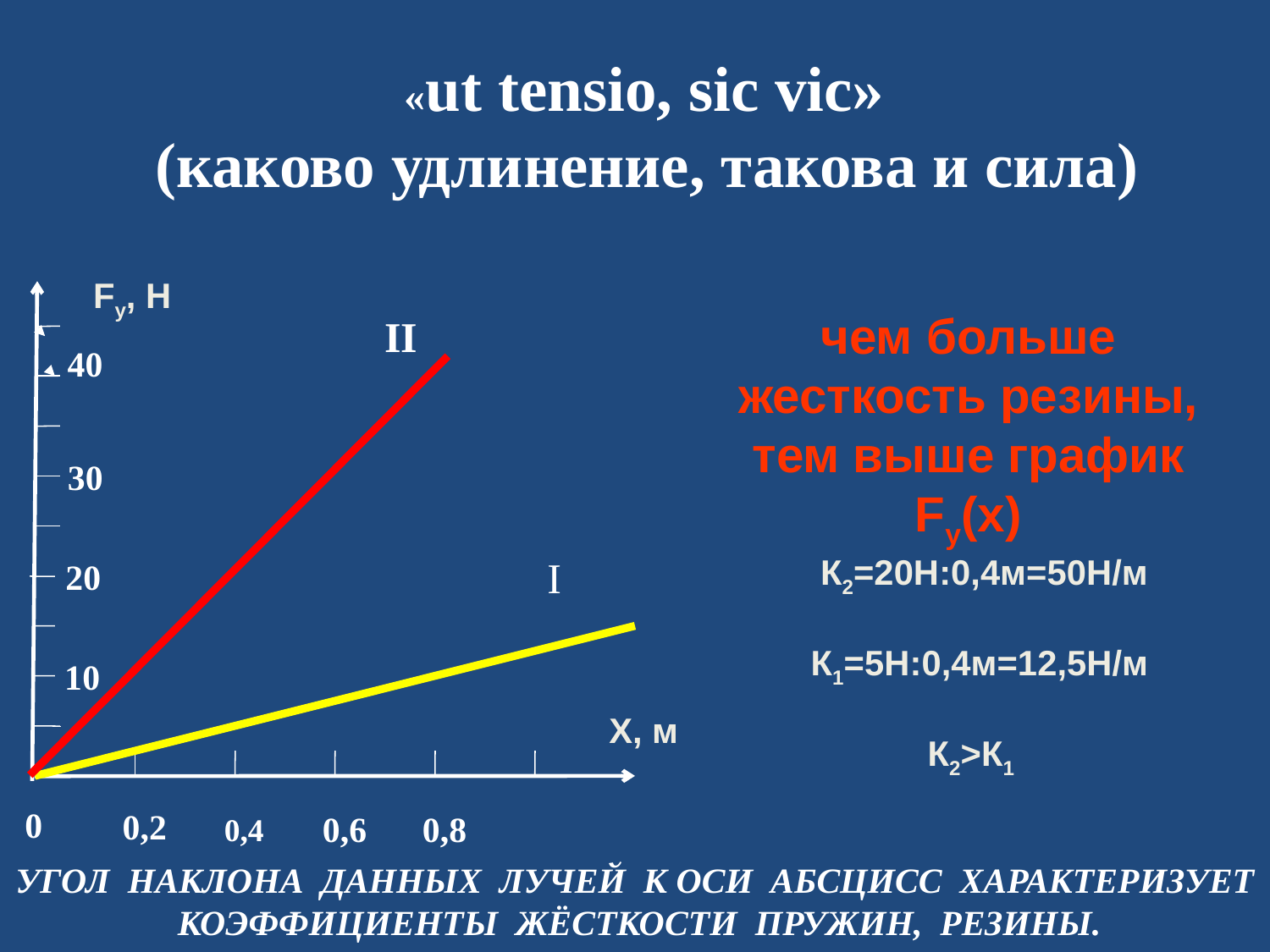
Is the value of line II at X = 0,8 м greater or less than 30 H? greater Which line has the steeper slope, I or II? II What is the highest value labelled on the vertical axis? 40 What colour is line II? red Is the value of line II at X = 0,4 м greater or less than 10 H? greater What is the label of the vertical axis? Fy, H Is the value of line I at X = 0,4 м greater or less than 10 H? less Do the values of line II rise or fall as X increases? rise How many lines (rays) are plotted on the chart? 2 Which line is higher on the chart, line I or line II? II What kind of chart is shown on the slide? line chart